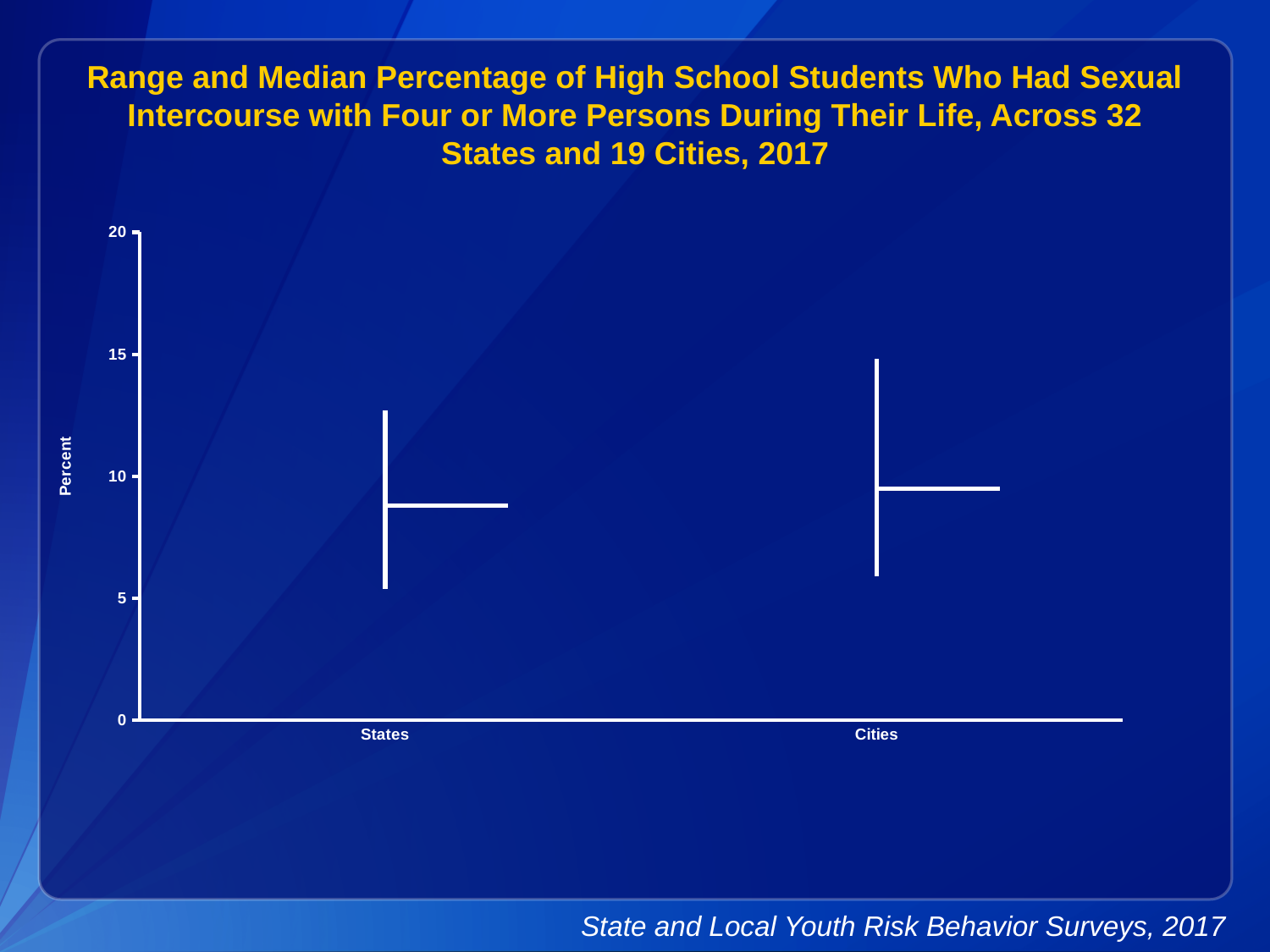
Is the median value for States greater or less than 10? less What are the two categories shown on the x axis? States and Cities Is the bottom of the range for Cities greater or less than 5? greater What is the label on the y axis of the chart? Percent How many categories are shown on the x axis of the chart? 2 What is the highest value shown on the y axis of the chart? 20 Is the top of the range for Cities greater or less than 10? greater Which category has the higher top of its range, States or Cities? Cities Which category has the higher median value, States or Cities? Cities